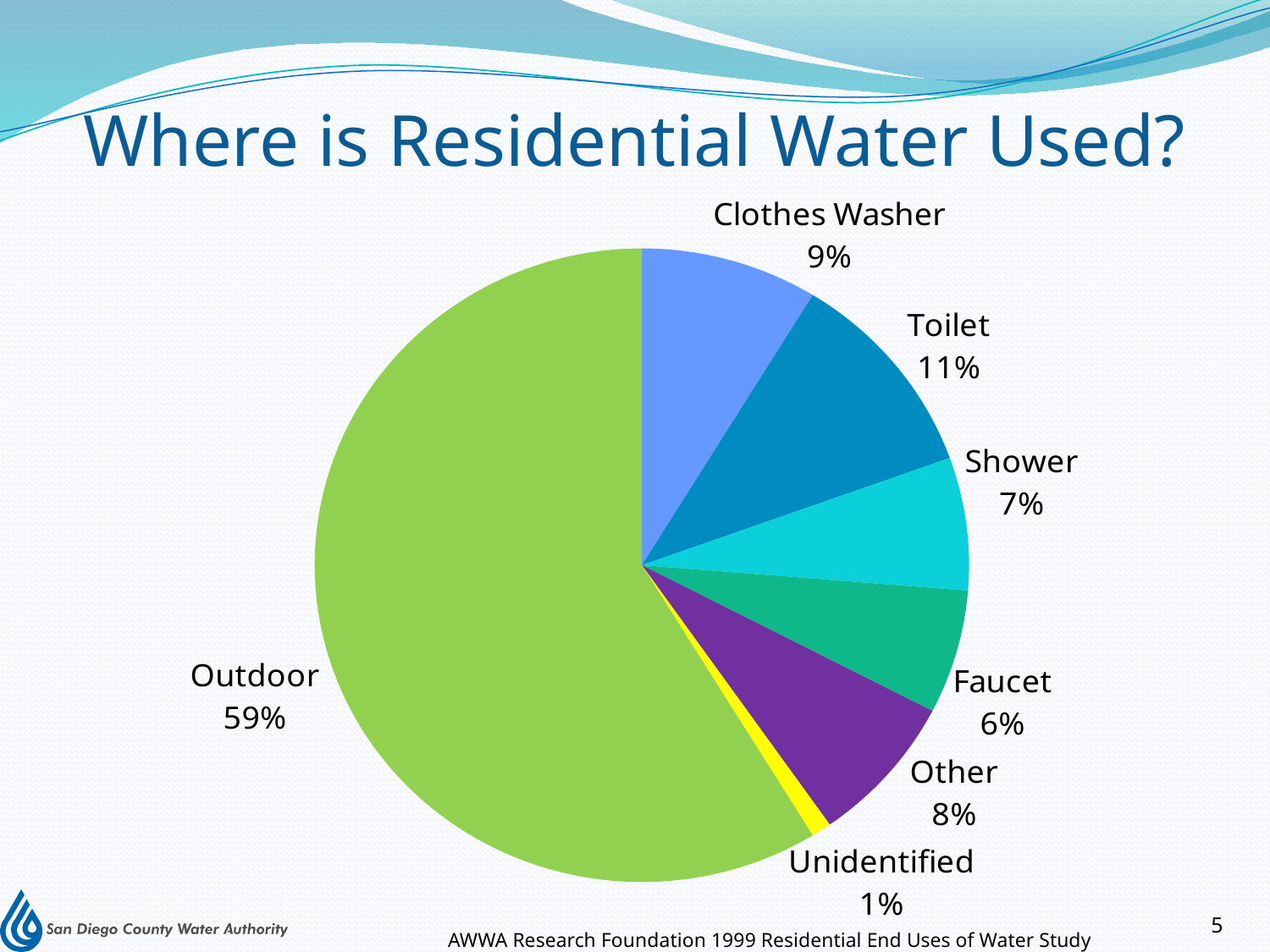
What percentage is shown for Clothes Washer? 9% Which category has the smallest slice of the pie? Unidentified What is the difference in percentage points between Toilet and Shower? 4 Which is larger, Other or Faucet? Other Which category has the largest slice of the pie? Outdoor What share of residential water use does Outdoor account for? 59% How many categories are shown in the pie chart? 7 What percentage is shown for Faucet? 6% What kind of chart is shown on the slide? Pie chart What colour is the Outdoor slice? Green What is the title of the slide containing the chart? Where is Residential Water Used? What percentage is shown for Toilet? 11%